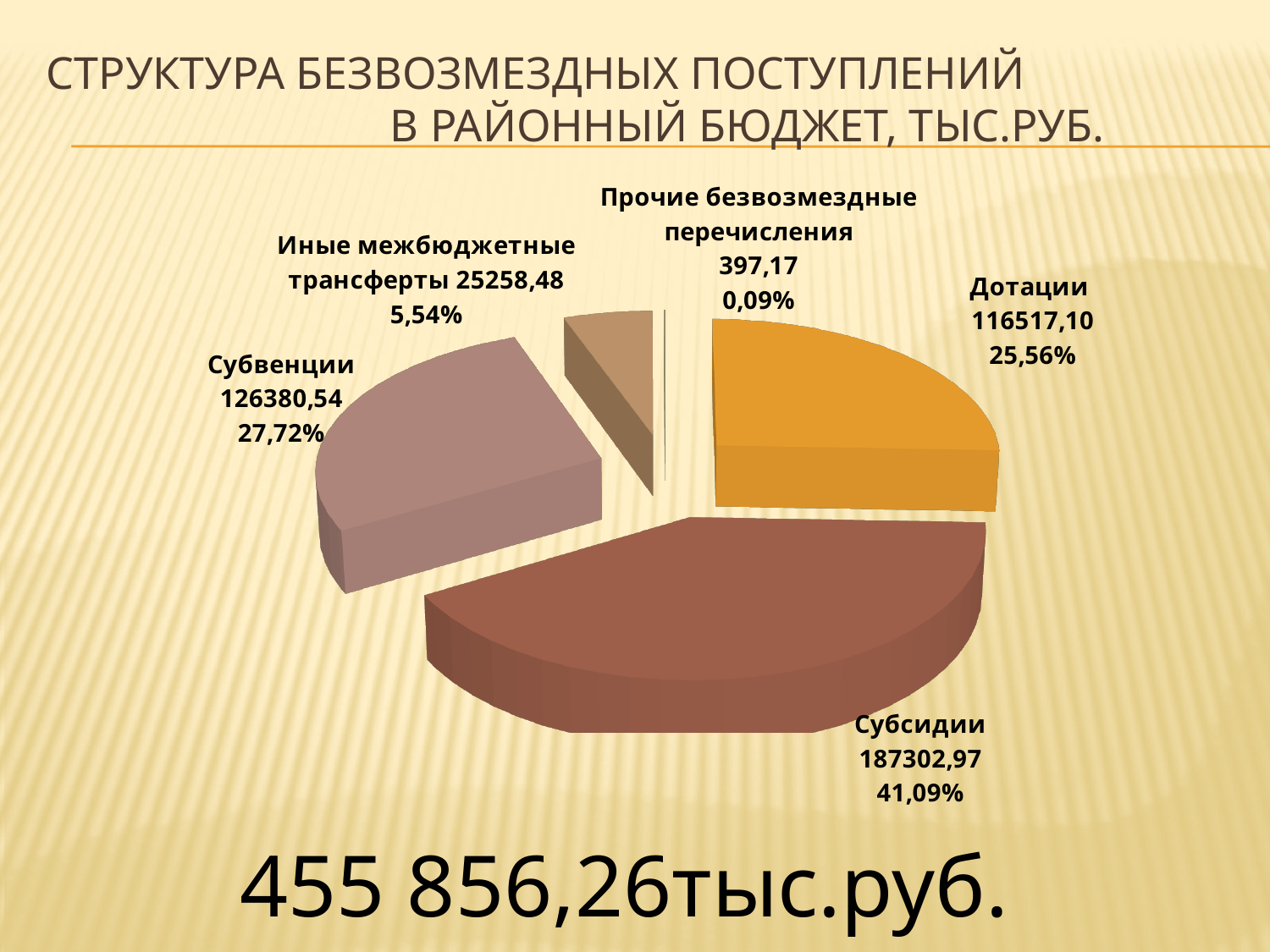
What kind of chart is shown on the slide? Pie chart What is the value for Дотации? 116517,10 What is the value for Прочие безвозмездные перечисления? 397,17 What share of the pie does Субвенции represent? 27,72% What share of the pie does Иные межбюджетные трансферты represent? 5,54% Which category has the largest slice of the pie? Субсидии How many slices does the pie chart have? 5 What is the value for Субсидии? 187302,97 What is the value for Субвенции? 126380,54 Which is larger, Субвенции or Дотации? Субвенции What is the difference between the values for Субсидии and Субвенции? 60922,43 Which category has the smallest slice of the pie? Прочие безвозмездные перечисления